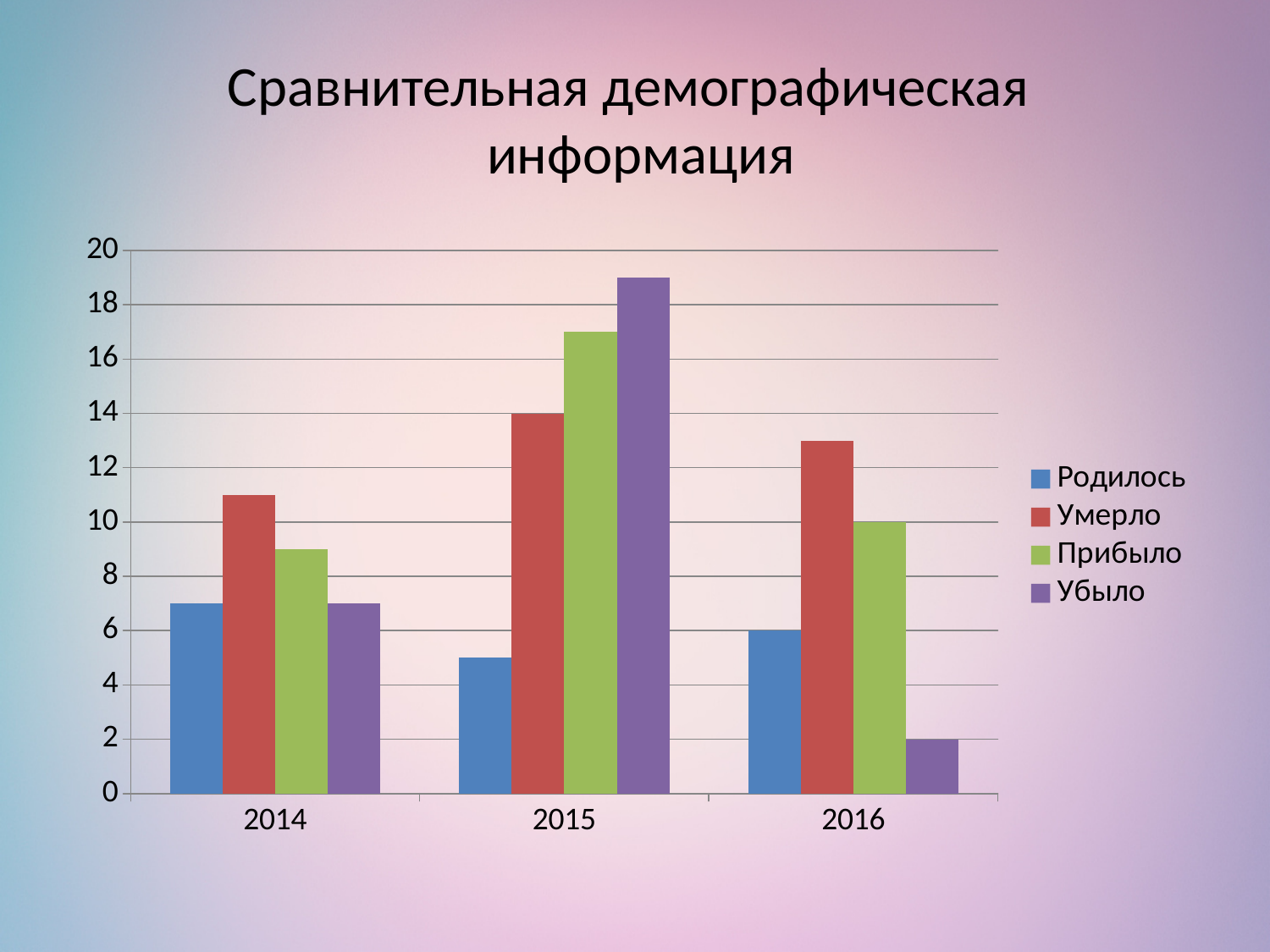
How many series does the legend list? 4 What is the value for Умерло in 2015? 14 What kind of chart is shown on the slide? bar chart How many years are shown on the x axis? 3 Which is larger in 2014, Умерло or Прибыло? Умерло Is the value for Убыло in 2015 greater or less than 18? greater Which series has the lowest value in 2016? Убыло What is the value for Родилось in 2016? 6 What is the value for Прибыло in 2016? 10 What is the value for Убыло in 2016? 2 What is the title of the chart? Сравнительная демографическая информация Which series has the highest value in 2015? Убыло